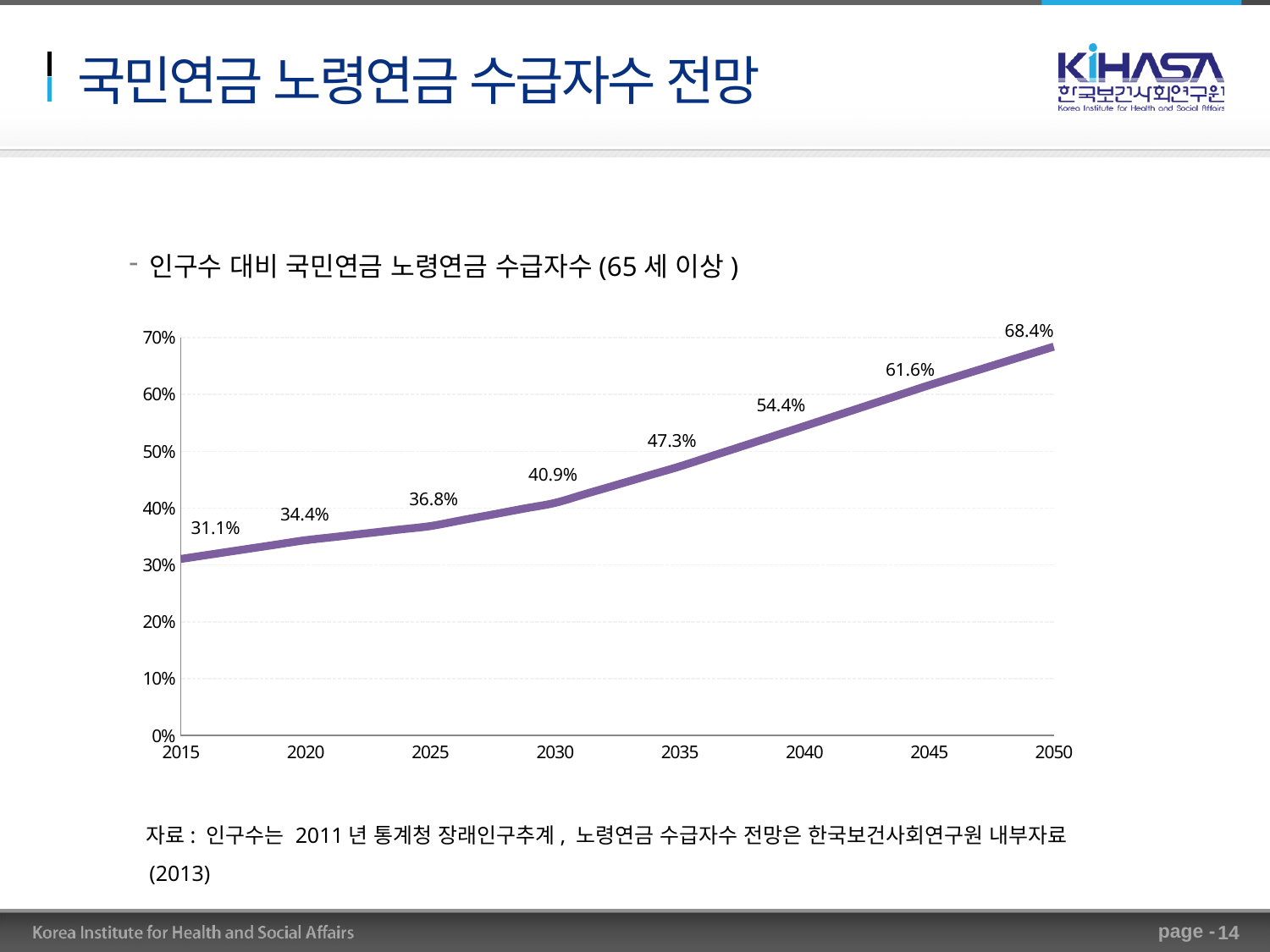
Which is larger, the value for 2045 or the value for 2040? 2045 What is the difference between the values for 2050 and 2015? 37.3% Which year has the lowest value? 2015 What is the value for 2050? 68.4% Do the values rise or fall from 2015 to 2050? rise What kind of chart is shown on the slide? line chart What is the value for 2030? 40.9% What is the difference between the values for 2035 and 2030? 6.4% What is the value for 2040? 54.4% What is the value for 2015? 31.1% Which year has the highest value? 2050